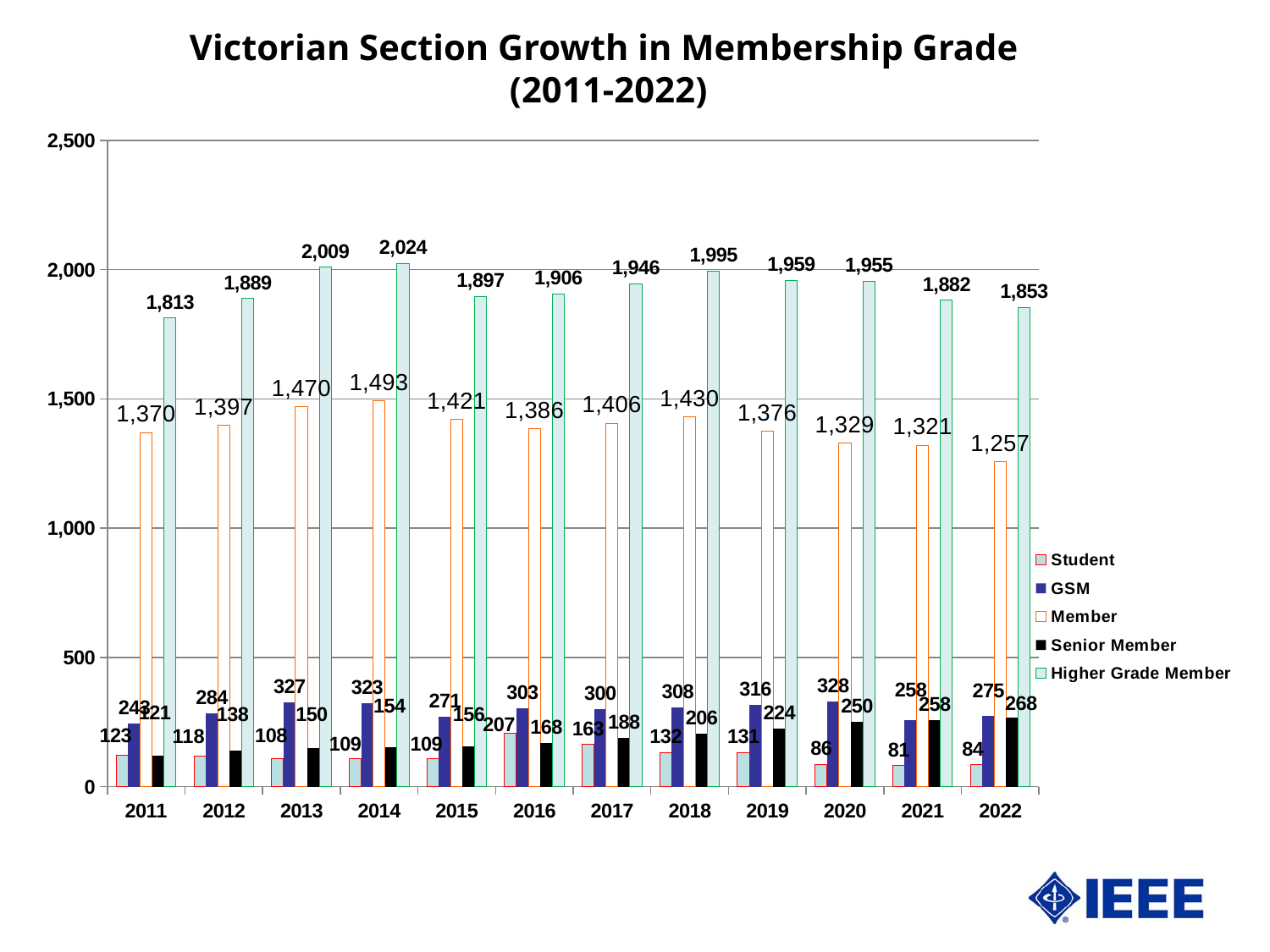
In which year is the Student value lowest? 2021 In which year is the Higher Grade Member value highest? 2014 Is the Higher Grade Member value in 2013 greater or less than 2,000? greater Does the Senior Member value rise or fall from 2011 to 2022? rise What is the value for Higher Grade Member in 2014? 2,024 What is the value for Senior Member in 2019? 224 What is the value for Member in 2022? 1,257 How many years are shown on the x axis? 12 How many series does the legend list? 5 What is the value for Student in 2016? 207 What is the difference between the Member values in 2014 and 2022? 236 Which is larger, the GSM value in 2020 or the GSM value in 2021? 2020